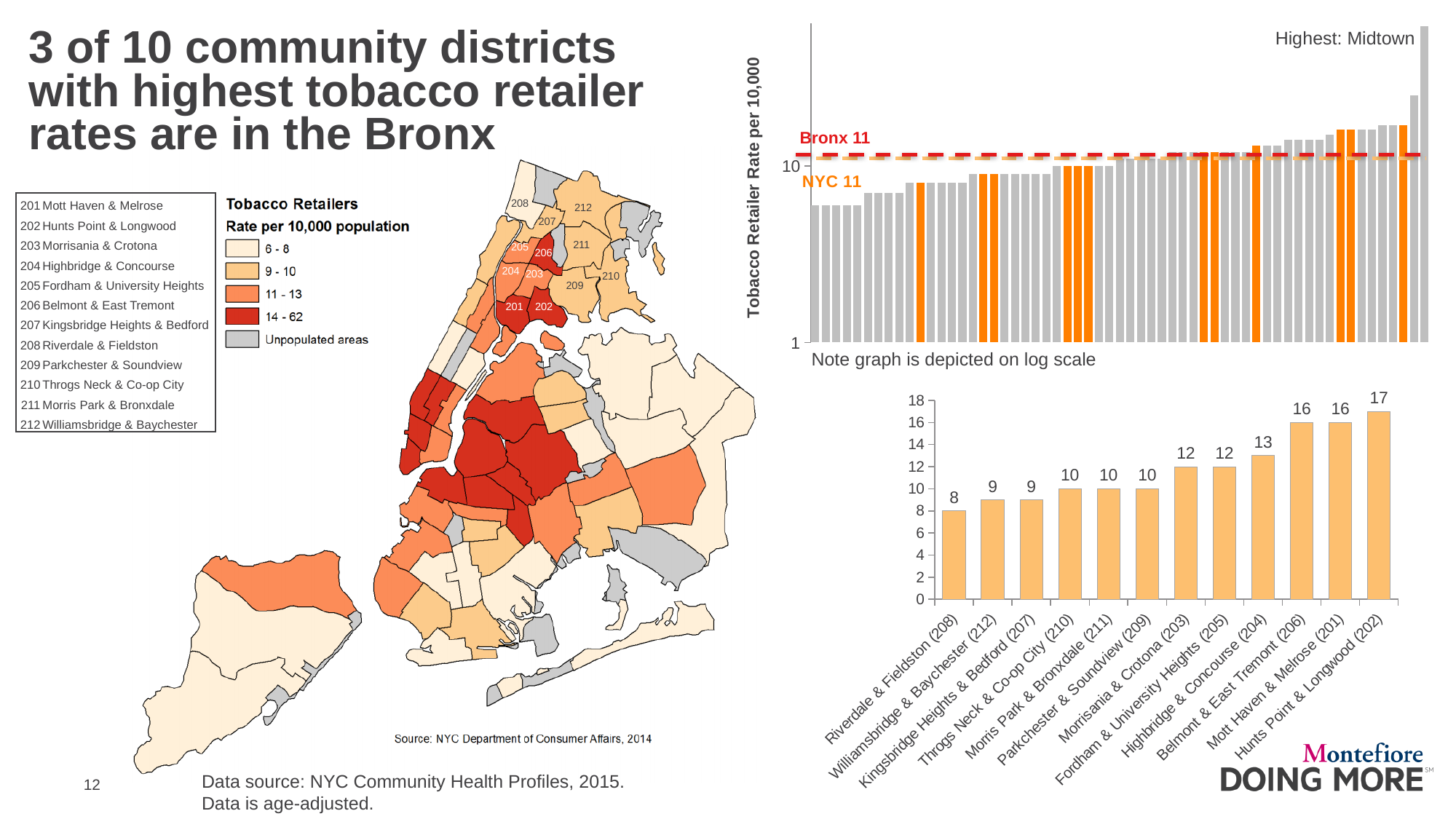
In the bottom-right bar chart, what is the value for Riverdale & Fieldston (208)? 8 In the bottom-right bar chart, what is the difference between the values for Hunts Point & Longwood (202) and Riverdale & Fieldston (208)? 9 How many community districts are shown in the bottom-right bar chart? 12 What kind of chart is the bottom-right chart? Bar chart In the bottom-right bar chart, which community district has the highest value? Hunts Point & Longwood (202) According to the top-right chart, which area has the highest tobacco retailer rate? Midtown In the bottom-right bar chart, which is larger: the value for Belmont & East Tremont (206) or the value for Highbridge & Concourse (204)? Belmont & East Tremont (206) In the bottom-right bar chart, do the values rise or fall from left to right? Rise In the bottom-right bar chart, what is the tobacco retailer rate for Hunts Point & Longwood (202)? 17 In the bottom-right bar chart, what is the value for Highbridge & Concourse (204)? 13 In the top-right chart, what is the Bronx tobacco retailer rate shown by the dashed reference line? 11 In the bottom-right bar chart, which community district has the lowest value? Riverdale & Fieldston (208)